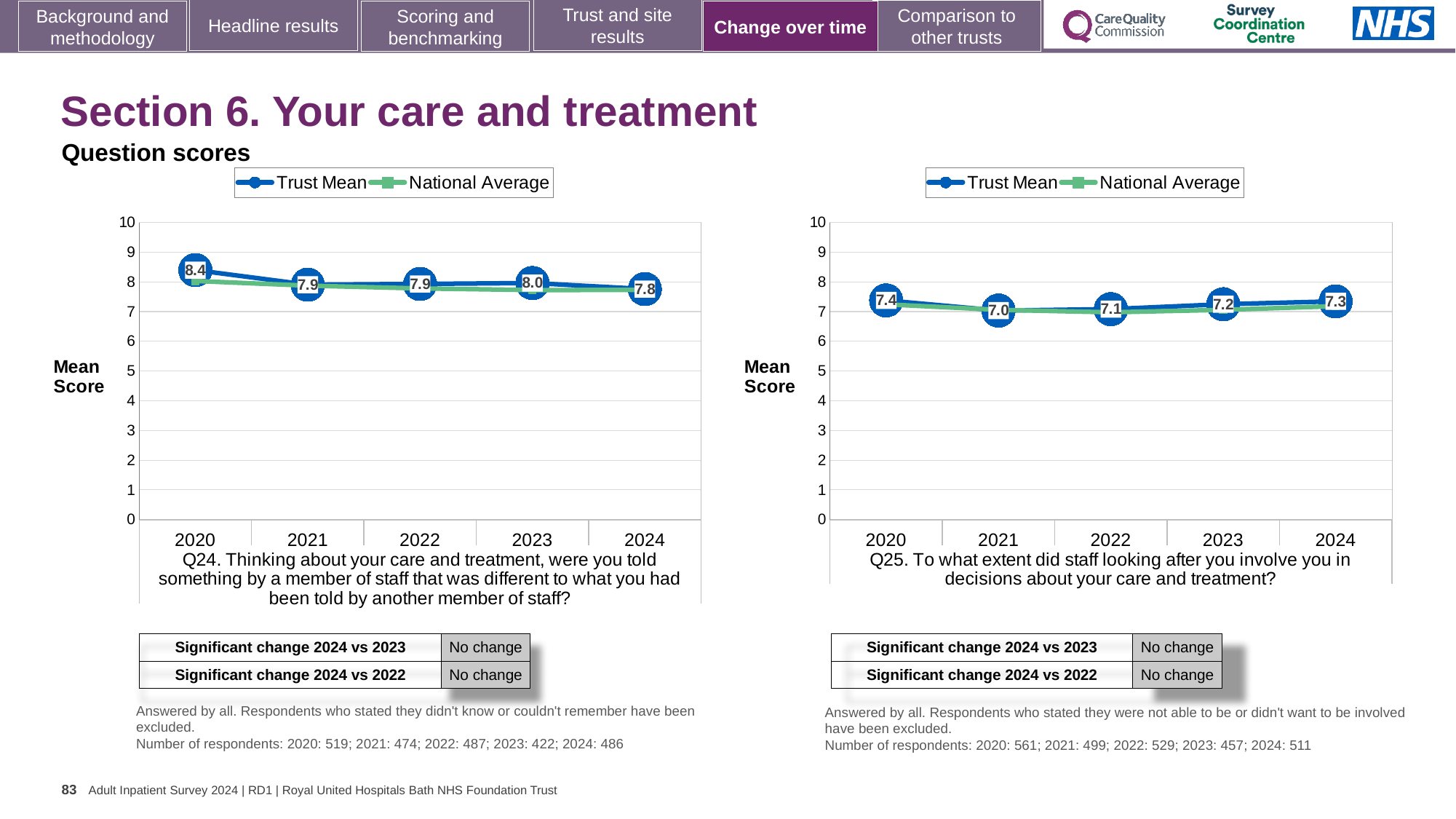
In the Q25 chart on the right, is the Trust Mean value for 2022 greater or less than 8? less In the Q24 chart on the left, what is the difference between the Trust Mean scores for 2020 and 2024? 0.6 How many years are plotted on the x axis of the Q24 chart on the left? 5 In the Q25 chart on the right, which year has the lowest Trust Mean score? 2021 In the Q24 chart on the left, which year has the highest Trust Mean score? 2020 In the Q25 chart on the right, what is the Trust Mean score for 2023? 7.2 In the Q25 chart on the right, is the Trust Mean score for 2020 larger or smaller than the score for 2024? larger In the Q24 chart on the left, what is the Trust Mean score for 2024? 7.8 What kind of chart is the Q24 chart on the left? Line chart How many series does the legend of the Q25 chart on the right list? 2 In the Q25 chart on the right, what is the Trust Mean score for 2021? 7.0 In the Q24 chart on the left, what is the Trust Mean score for 2020? 8.4